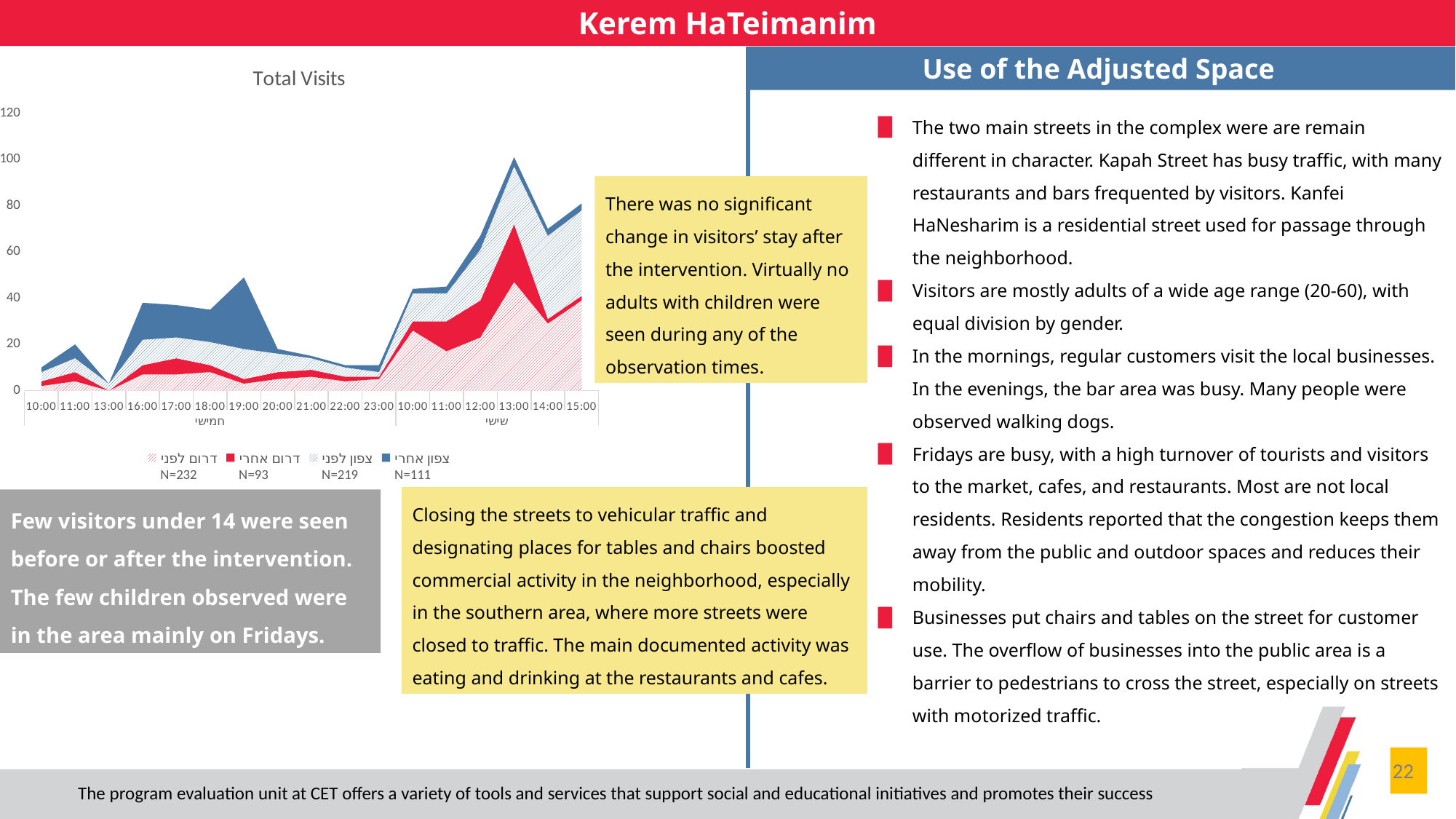
In the "Total Visits" chart, at which time point does the top (blue) series reach its lowest value? 13:00 (חמישי) What kind of chart is shown under the title "Total Visits"? Area chart What is the title of the chart on the left of the slide? Total Visits How many time points are plotted along the x axis of the "Total Visits" chart? 17 In the "Total Visits" chart legend, what N value is shown for דרום לפני? N=232 In the "Total Visits" chart, which is larger for the top (blue) series: the value at 13:00 on שישי or the value at 19:00 on חמישי? 19:00 on חמישי How many series does the legend of the "Total Visits" chart list? 4 In the "Total Visits" chart, at which time point does the top (blue, צפון אחרי) series reach its highest value? 19:00 (חמישי) In the "Total Visits" chart, is the value of the top (blue) series at 19:00 on חמישי greater or less than 20? greater In the "Total Visits" chart, is the value of the top (blue) series at 13:00 on שישי greater or less than 80? less In the "Total Visits" chart, is the value of the top (blue) series at 13:00 on חמישי greater or less than 20? less